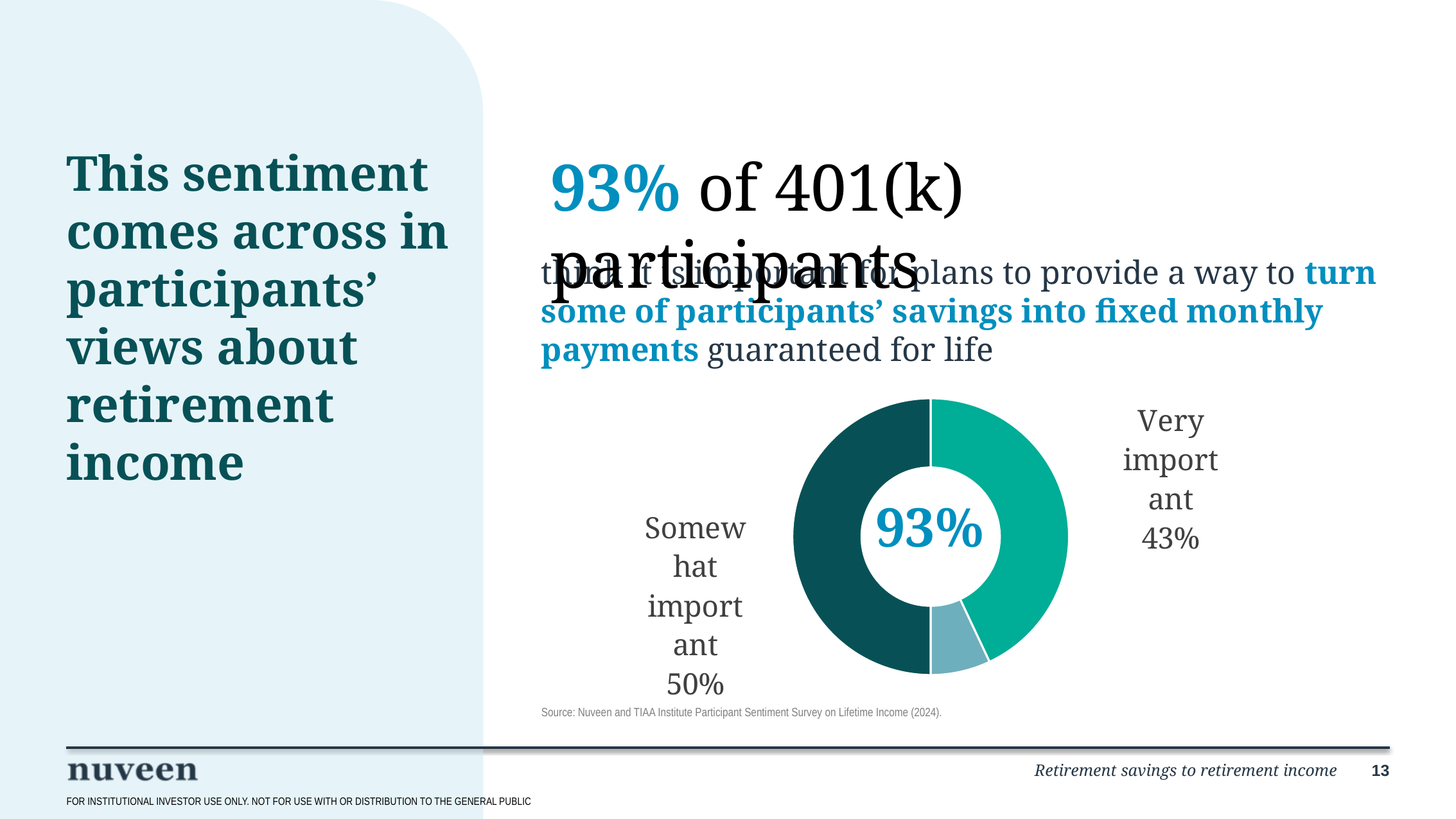
What kind of chart is shown on the slide? Pie chart (donut) What share of the pie does the 'Somewhat important' slice represent? 50% Of the two labelled slices, which has the highest value? Somewhat important What is the source cited below the chart? Nuveen and TIAA Institute Participant Sentiment Survey on Lifetime Income (2024) Which slice of the donut chart is shown in the darkest colour? Somewhat important What is the difference between the 'Somewhat important' share and the 'Very important' share? 7% Which is larger, the 'Very important' share or the 'Somewhat important' share? Somewhat important What percentage of participants said it is 'Somewhat important'? 50% What is the combined share of the 'Very important' and 'Somewhat important' slices? 93% What value is printed in the centre of the donut chart? 93% What percentage of participants said it is 'Very important'? 43% How many slices does the donut chart have? 3